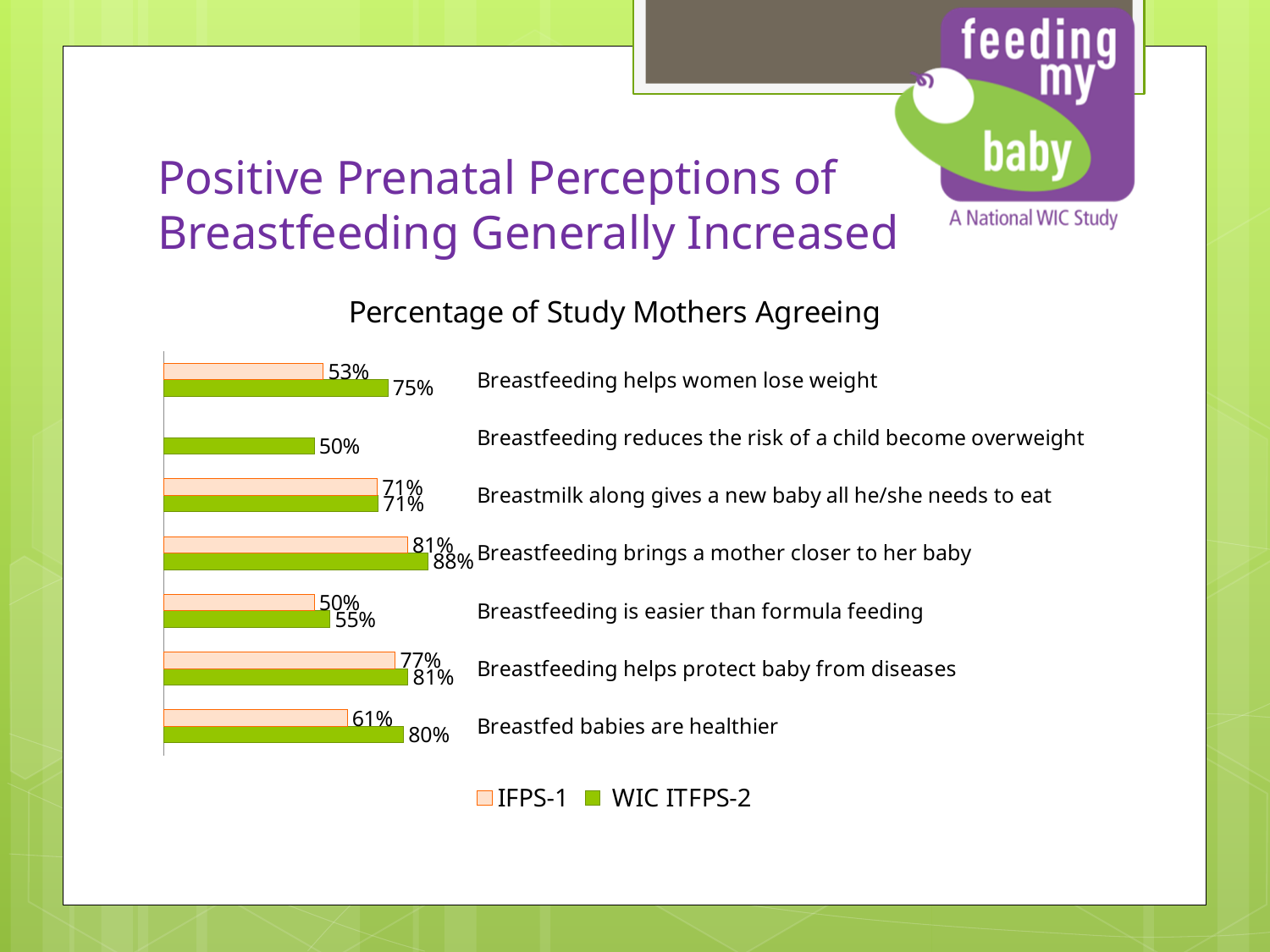
For 'Breastfeeding helps protect baby from diseases', which series has the larger value, IFPS-1 or WIC ITFPS-2? WIC ITFPS-2 Which statement has the lowest IFPS-1 percentage? Breastfeeding is easier than formula feeding How many series does the legend list? 2 What is the title of the chart? Percentage of Study Mothers Agreeing What percentage of WIC ITFPS-2 mothers agreed that breastfeeding helps women lose weight? 75% Which statement has the highest WIC ITFPS-2 percentage? Breastfeeding brings a mother closer to her baby What is the difference between the IFPS-1 and WIC ITFPS-2 percentages for 'Breastmilk along gives a new baby all he/she needs to eat'? 0% What is the difference between the WIC ITFPS-2 and IFPS-1 percentages for 'Breastfed babies are healthier'? 19% What type of chart is shown on the slide? Bar chart What percentage of WIC ITFPS-2 mothers agreed that breastfeeding reduces the risk of a child become overweight? 50% What percentage of IFPS-1 mothers agreed that breastfed babies are healthier? 61% How many statements (categories) are shown in the chart? 7